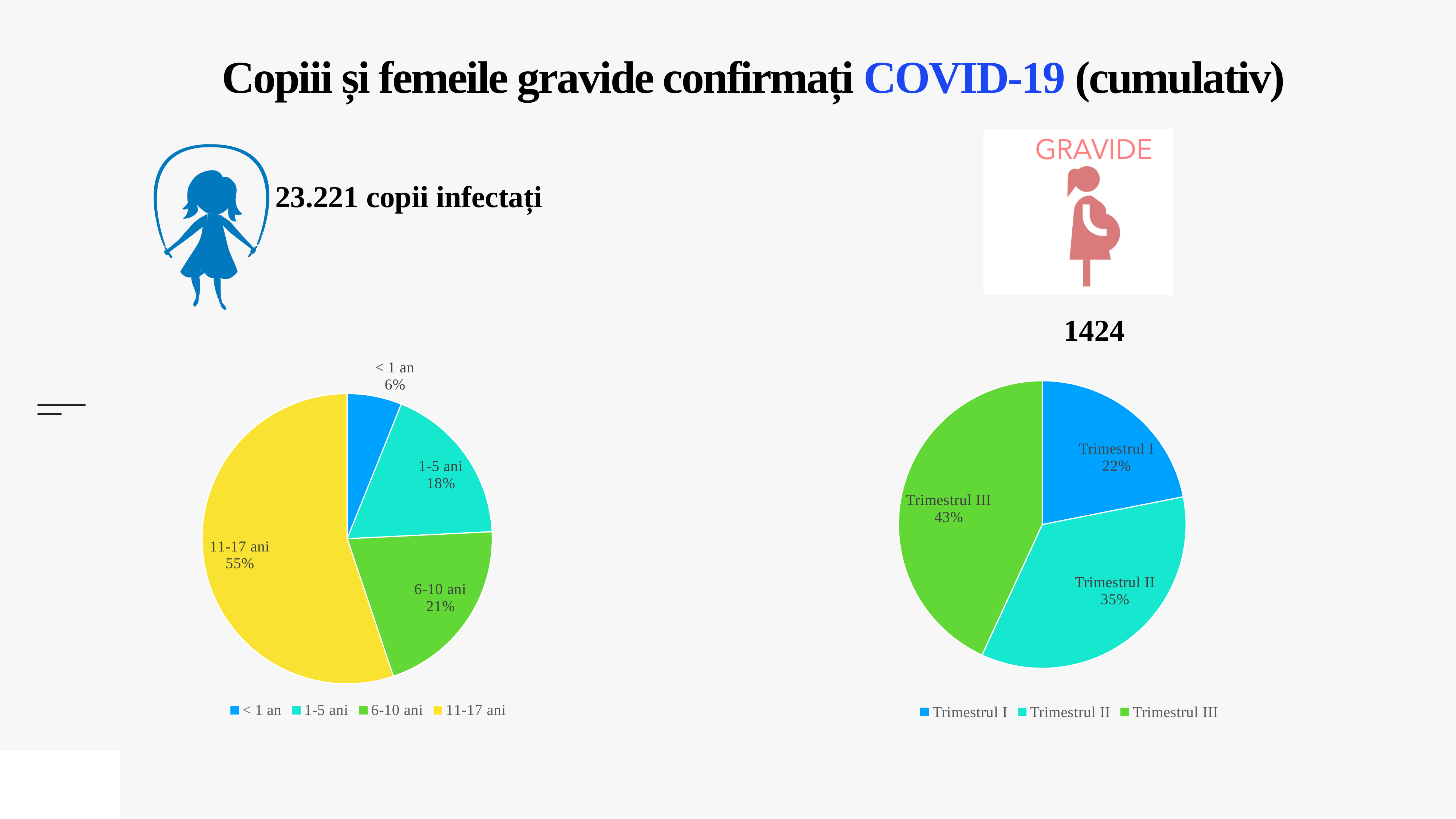
In the left pie chart (children by age group), which age group has the largest share? 11-17 ani What type of chart is used on the right side of the slide for pregnant women by trimester? Pie chart In the left pie chart (children by age group), which age group has the smallest share? < 1 an In the left pie chart (children by age group), what share is shown for the < 1 an slice? 6% In the left pie chart (children by age group), what share is shown for the 11-17 ani slice? 55% In the right pie chart (pregnant women by trimester), which trimester has the largest share? Trimestrul III In the right pie chart (pregnant women by trimester), what is the difference in percentage points between Trimestrul III and Trimestrul I? 21 How many entries does the legend of the right pie chart (pregnant women by trimester) list? 3 In the left pie chart (children by age group), how many slices are there? 4 In the right pie chart (pregnant women by trimester), which is larger, Trimestrul I or Trimestrul II? Trimestrul II In the left pie chart (children by age group), what is the difference in percentage points between the 6-10 ani and 1-5 ani slices? 3 In the right pie chart (pregnant women by trimester), what share is shown for Trimestrul II? 35%